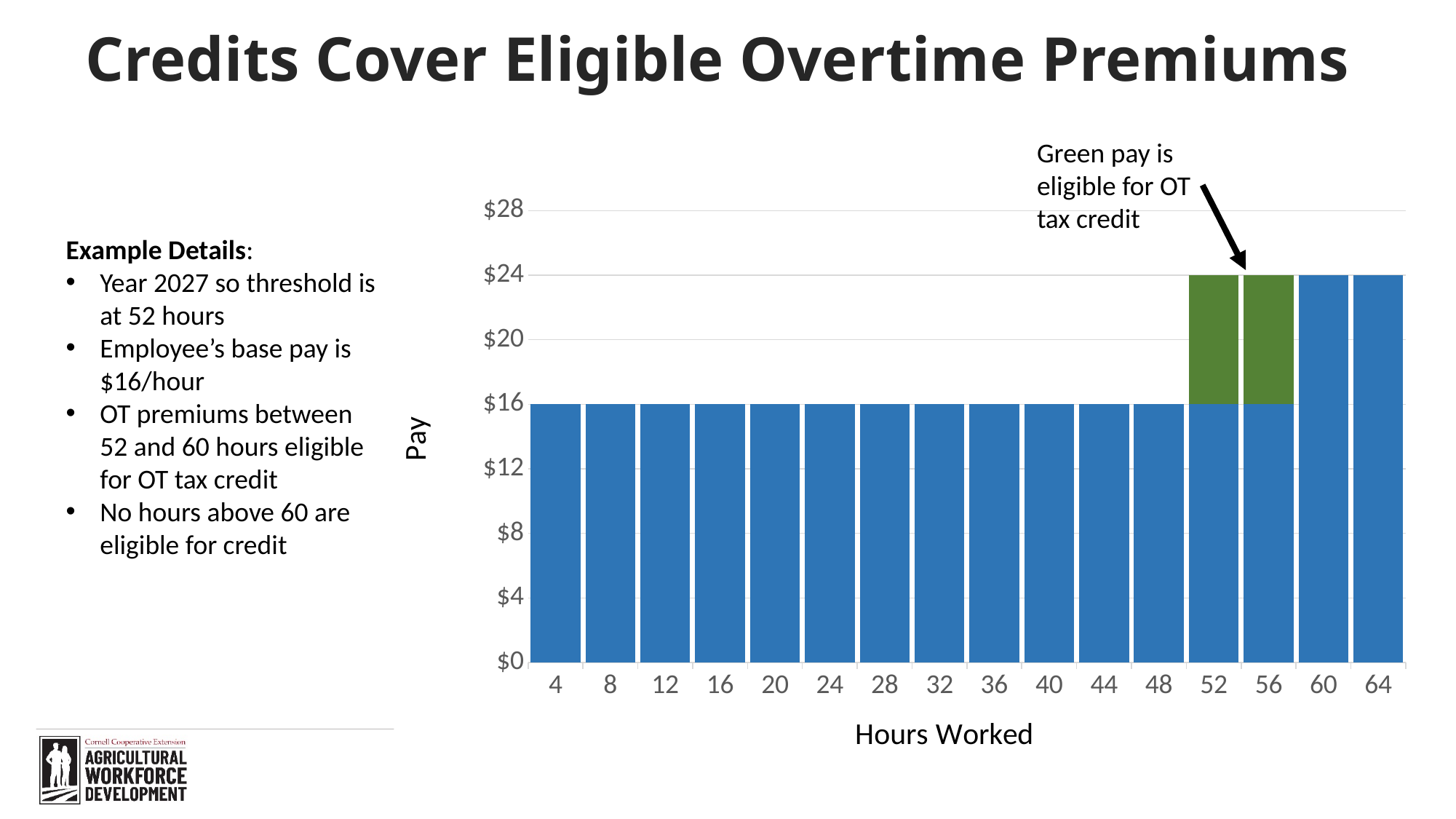
Which is larger, the pay value at 64 hours or the pay value at 32 hours? 64 hours What is the label of the x axis? Hours Worked What is the label of the y axis? Pay What is the pay value for 4 hours worked? $16 Do the pay values rise or fall moving from 48 hours to 52 hours on the x axis? rise How many bars are plotted in the chart? 16 Is the pay value for 64 hours worked greater or less than $20? greater Is the pay value for 40 hours worked greater or less than $20? less What is the pay value for 52 hours worked? $24 What is the difference between the pay value at 56 hours and the pay value at 48 hours? $8 What is the pay value for 60 hours worked? $24 What kind of chart is shown on the slide? bar chart